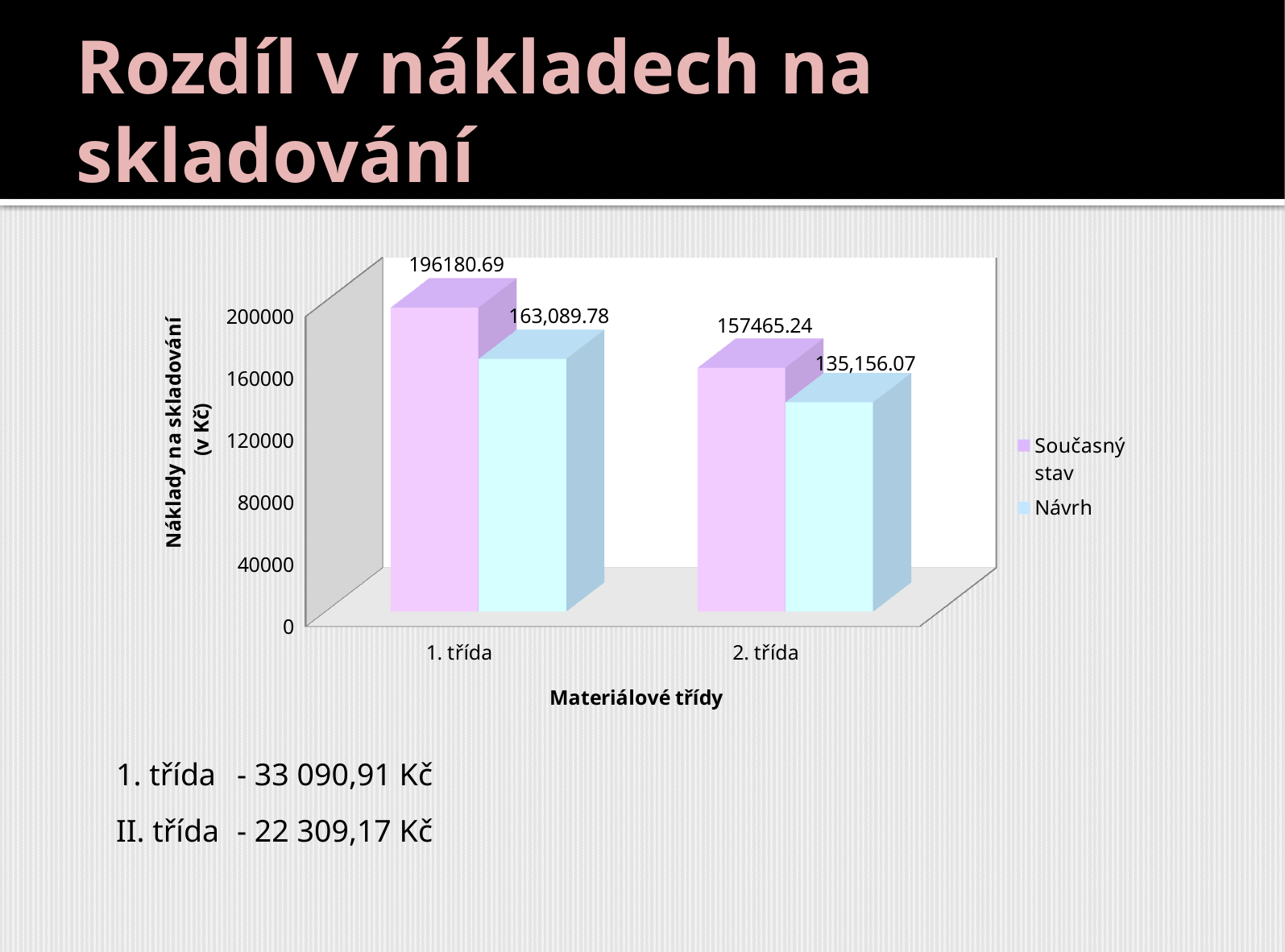
What is the value for Návrh for 1. třída? 163,089.78 What is the value for Současný stav for 2. třída? 157465.24 How many material classes (categories) are shown on the x axis? 2 Which category has the highest Současný stav value? 1. třída What is the difference between Současný stav and Návrh for 2. třída? 22309.17 Which category has the lowest Návrh value? 2. třída What is the difference between Současný stav and Návrh for 1. třída? 33090.91 How many series does the legend list? 2 What kind of chart is shown on the slide? Bar chart Which is larger for 2. třída, Současný stav or Návrh? Současný stav What is the value for Návrh for 2. třída? 135,156.07 What is the value for Současný stav for 1. třída? 196180.69